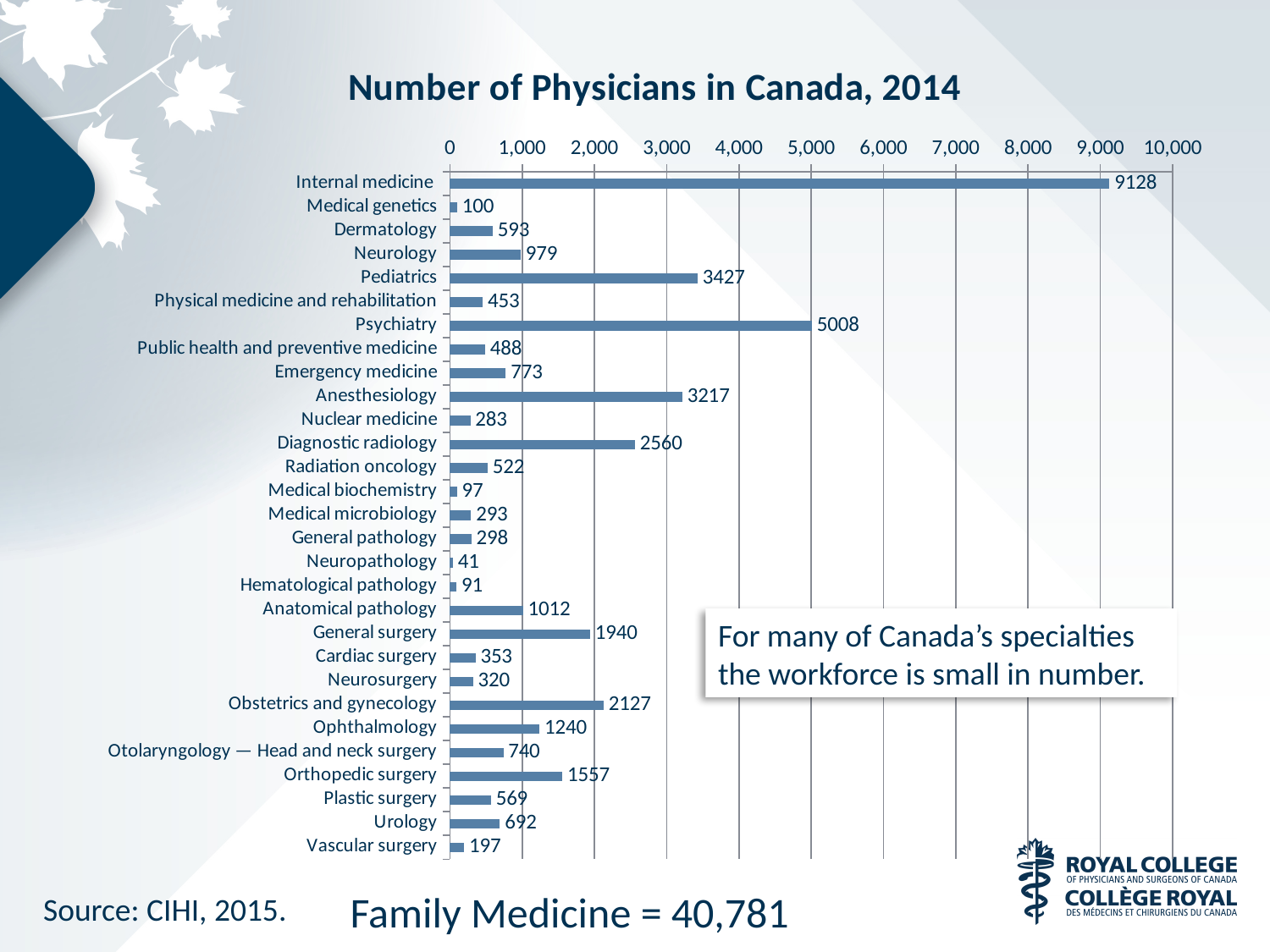
What is the difference between the number of physicians in Psychiatry and in Pediatrics? 1581 What is the number of physicians in Psychiatry? 5008 What kind of chart is shown on the slide? Bar chart Which has more physicians, Anesthesiology or Pediatrics? Pediatrics Is the value for Obstetrics and gynecology greater or less than 2,000? greater How many specialties are shown in the chart? 29 What is the number of physicians in Orthopedic surgery? 1557 What is the title of the chart? Number of Physicians in Canada, 2014 What is the number of physicians in Internal medicine? 9128 Which specialty has the highest number of physicians? Internal medicine What is the number of physicians in Diagnostic radiology? 2560 Which specialty has the lowest number of physicians? Neuropathology